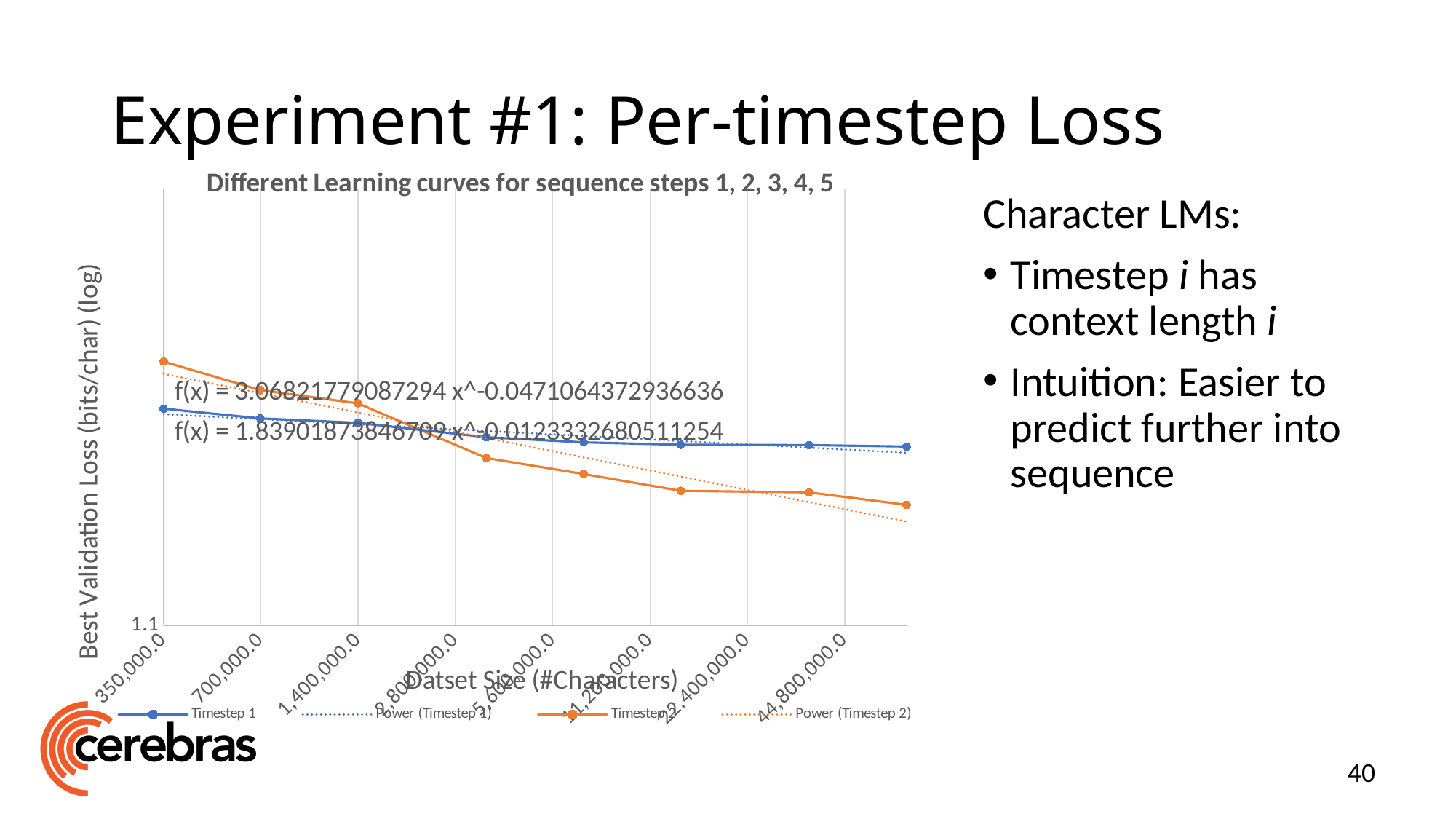
At which dataset size does the Timestep 2 series reach its highest validation loss? 350,000.0 Does the Timestep 2 series rise or fall as dataset size increases along the x axis? fall What kind of chart is shown on the slide? line chart Is the validation loss for Timestep 2 at 44,800,000.0 greater or less than 1.1? greater How many entries does the chart legend list? 4 What is the label of the y axis? Best Validation Loss (bits/char) (log) At the largest dataset size on the chart, which series has the higher validation loss, Timestep 1 or Timestep 2? Timestep 1 What is the label of the x axis? Datset Size (#Characters) At the smallest dataset size (350,000.0), which series has the higher validation loss, Timestep 1 or Timestep 2? Timestep 2 How many data points are plotted for the Timestep 2 series? 8 What is the title of the chart? Different Learning curves for sequence steps 1, 2, 3, 4, 5 Does the Timestep 1 series rise or fall as dataset size increases along the x axis? fall